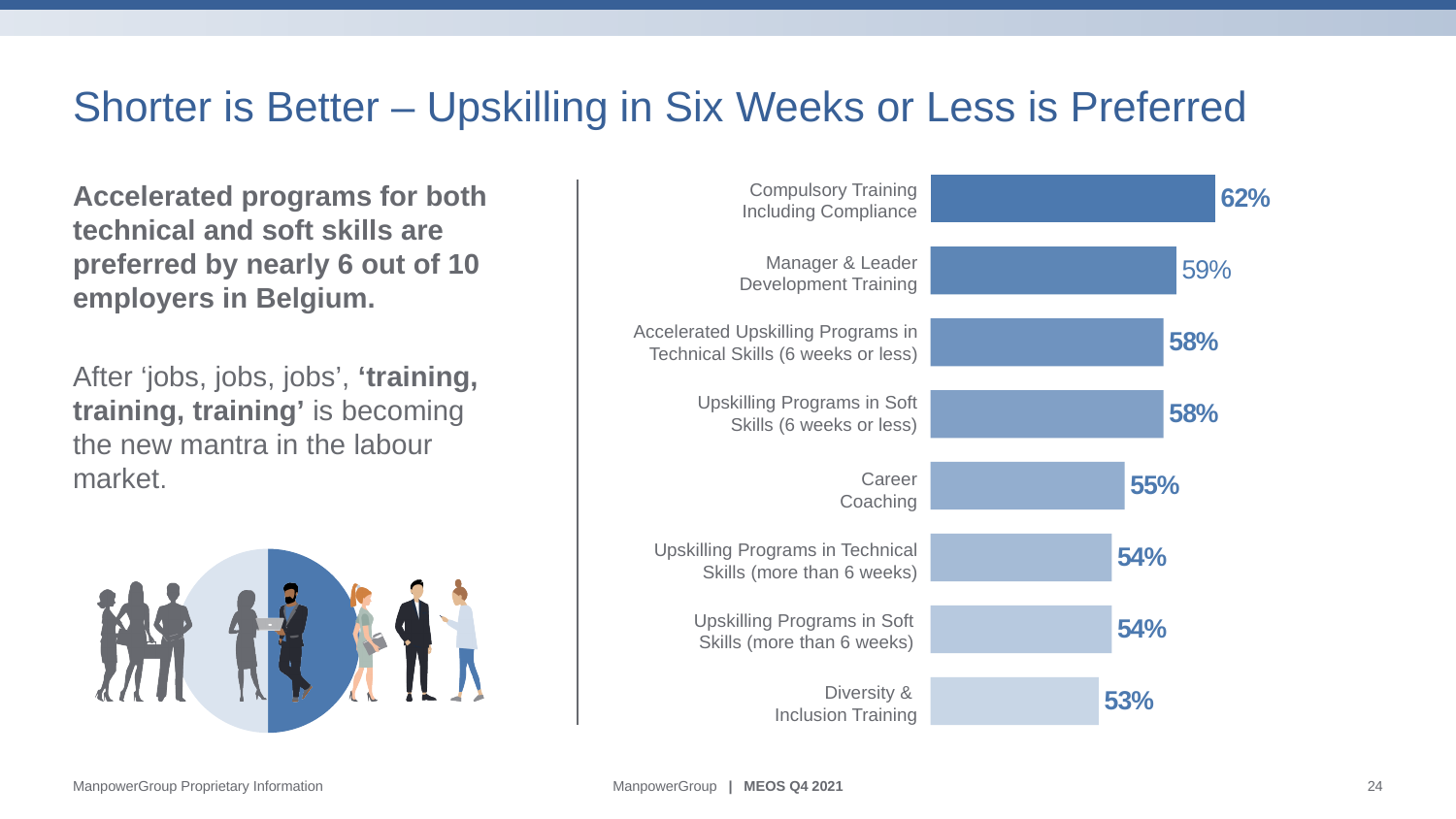
What is the value for Diversity & Inclusion Training? 53% Which category has the highest value? Compulsory Training Including Compliance Which is larger: Career Coaching or Upskilling Programs in Soft Skills (more than 6 weeks)? Career Coaching What is the title of the slide containing the chart? Shorter is Better – Upskilling in Six Weeks or Less is Preferred What is the value for Career Coaching? 55% How many categories are shown in the chart? 8 What kind of chart is shown on the slide? Bar chart Which category has the lowest value? Diversity & Inclusion Training What is the difference between Compulsory Training Including Compliance and Diversity & Inclusion Training? 9% What is the value for Compulsory Training Including Compliance? 62% What is the difference between Accelerated Upskilling Programs in Technical Skills (6 weeks or less) and Upskilling Programs in Technical Skills (more than 6 weeks)? 4% What is the value for Manager & Leader Development Training? 59%